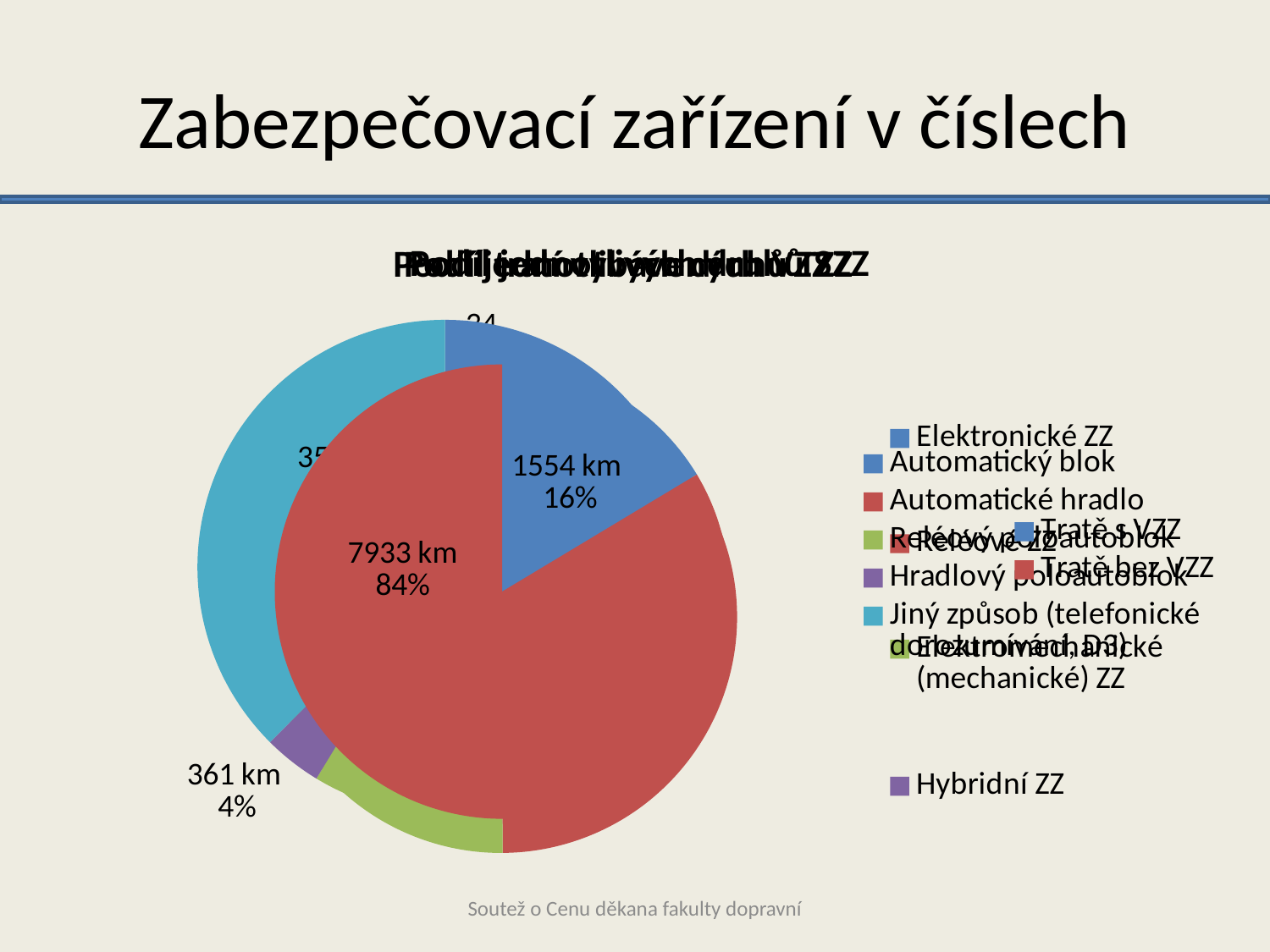
In the front pie chart, what percentage share does the Tratě bez VZZ slice have? 84% What kind of chart is shown on the slide? pie chart In the front pie chart, what value is shown for the red slice (Tratě bez VZZ)? 7933 km In the front pie chart, what is the total of the two slices in km? 9487 km In the front pie chart, what percentage share does the Tratě s VZZ slice have? 16% In the front pie chart, what value is shown for the blue slice (Tratě s VZZ)? 1554 km In the front pie chart, which slice is larger, Tratě s VZZ or Tratě bez VZZ? Tratě bez VZZ In the back pie chart, what value is shown on the label reading 4%? 361 km In the front pie chart, which colour represents Tratě bez VZZ? red In the front pie chart, what is the difference in km between the Tratě bez VZZ and Tratě s VZZ slices? 6379 km How many slices does the front pie chart have? 2